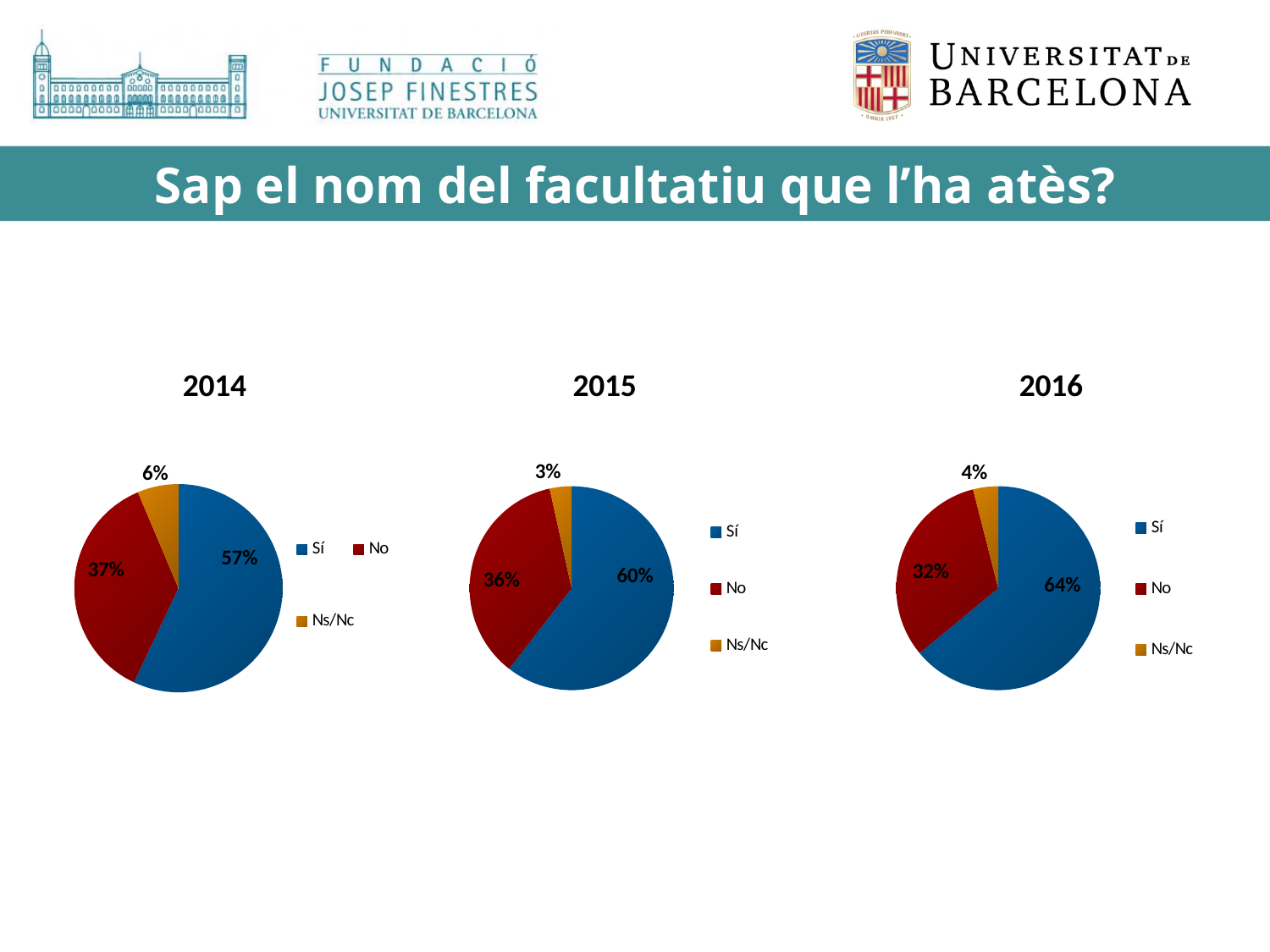
Across the 2014, 2015 and 2016 pie charts, does the Sí share rise or fall over the years? Rise How many slices does the 2015 pie chart have? 3 In the 2016 pie chart, which category has the largest slice? Sí In the 2016 pie chart, what percentage is shown for Ns/Nc? 4% What is the title of the 2015 pie chart? 2015 Is the Sí share larger in the 2014 pie chart or in the 2016 pie chart? 2016 How many entries does the legend of the 2016 pie chart list? 3 What type of chart is used for 2014? Pie chart In the 2015 pie chart, what is the difference between the Sí and No percentages? 24% In the 2015 pie chart, what percentage is shown for No? 36% In the 2014 pie chart, what percentage is shown for Sí? 57% In the 2014 pie chart, which category has the smallest slice? Ns/Nc